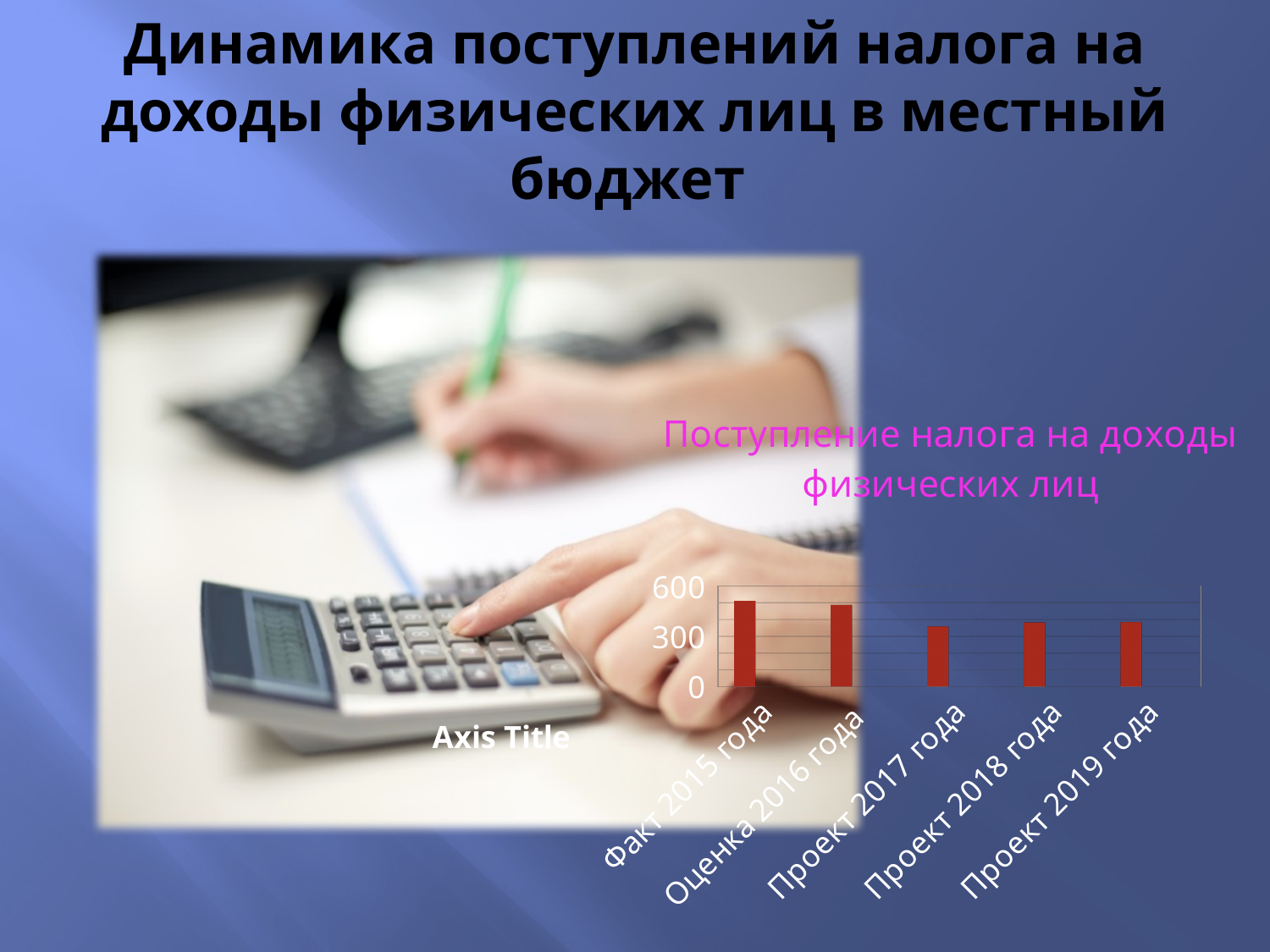
Is the value for Факт 2015 года greater or less than 300? greater How many categories are plotted in the chart? 5 What is the label of the first category on the x axis? Факт 2015 года Is the value for Проект 2019 года greater or less than 600? less Which is larger, the value for Оценка 2016 года or the value for Проект 2018 года? Оценка 2016 года What kind of chart is shown on the slide? bar chart What is the title of the chart? Поступление налога на доходы физических лиц Which is larger, the value for Факт 2015 года or the value for Проект 2017 года? Факт 2015 года What colour are the bars in the chart? red Is the value for Факт 2015 года greater or less than 600? less Is the value for Проект 2019 года higher or lower than the value for Факт 2015 года? lower